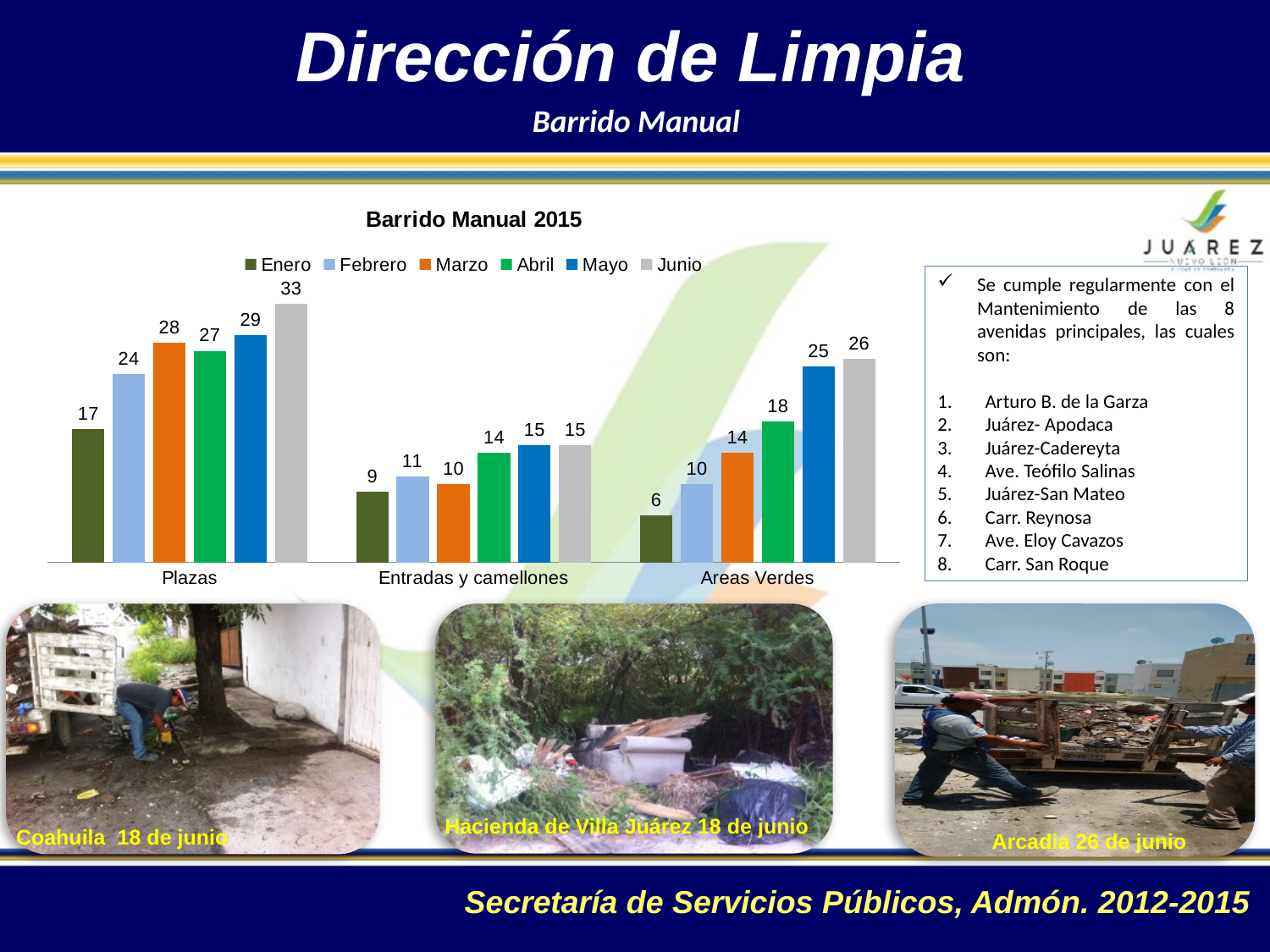
What kind of chart is shown on the slide? bar chart Which month has the lowest value in the Areas Verdes category? Enero Which is larger: the Marzo value for Plazas or the Marzo value for Areas Verdes? Plazas What is the value for Enero in the Areas Verdes category? 6 What is the value for Junio in the Plazas category? 33 What is the title of the chart? Barrido Manual 2015 What is the difference between the Mayo and Enero values in the Areas Verdes category? 19 Which month has the highest value in the Plazas category? Junio How many categories are shown on the x axis of the chart? 3 Do the values for Areas Verdes rise or fall from Enero to Junio? rise What is the value for Abril in the Entradas y camellones category? 14 How many series does the chart legend list? 6